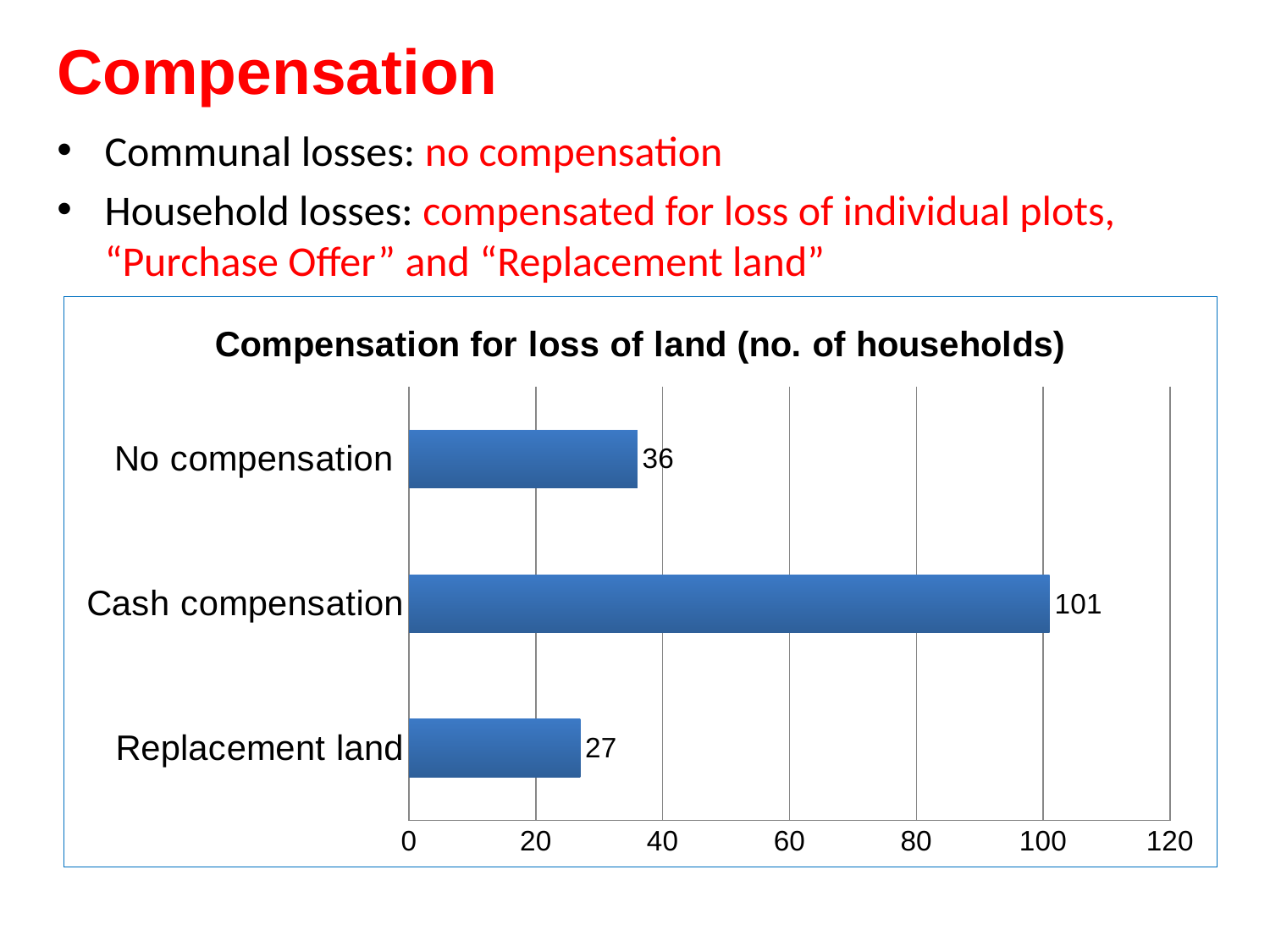
Which is larger, No compensation or Replacement land? No compensation How many categories are shown in the chart? 3 What is the value for No compensation? 36 What is the value for Replacement land? 27 What is the title of the chart? Compensation for loss of land (no. of households) What is the difference between No compensation and Replacement land? 9 What kind of chart is shown on the slide? Bar chart Which category has the lowest number of households? Replacement land What is the difference between Cash compensation and No compensation? 65 What is the value for Cash compensation? 101 Which category has the highest number of households? Cash compensation Is the value for Cash compensation greater or less than 100? greater